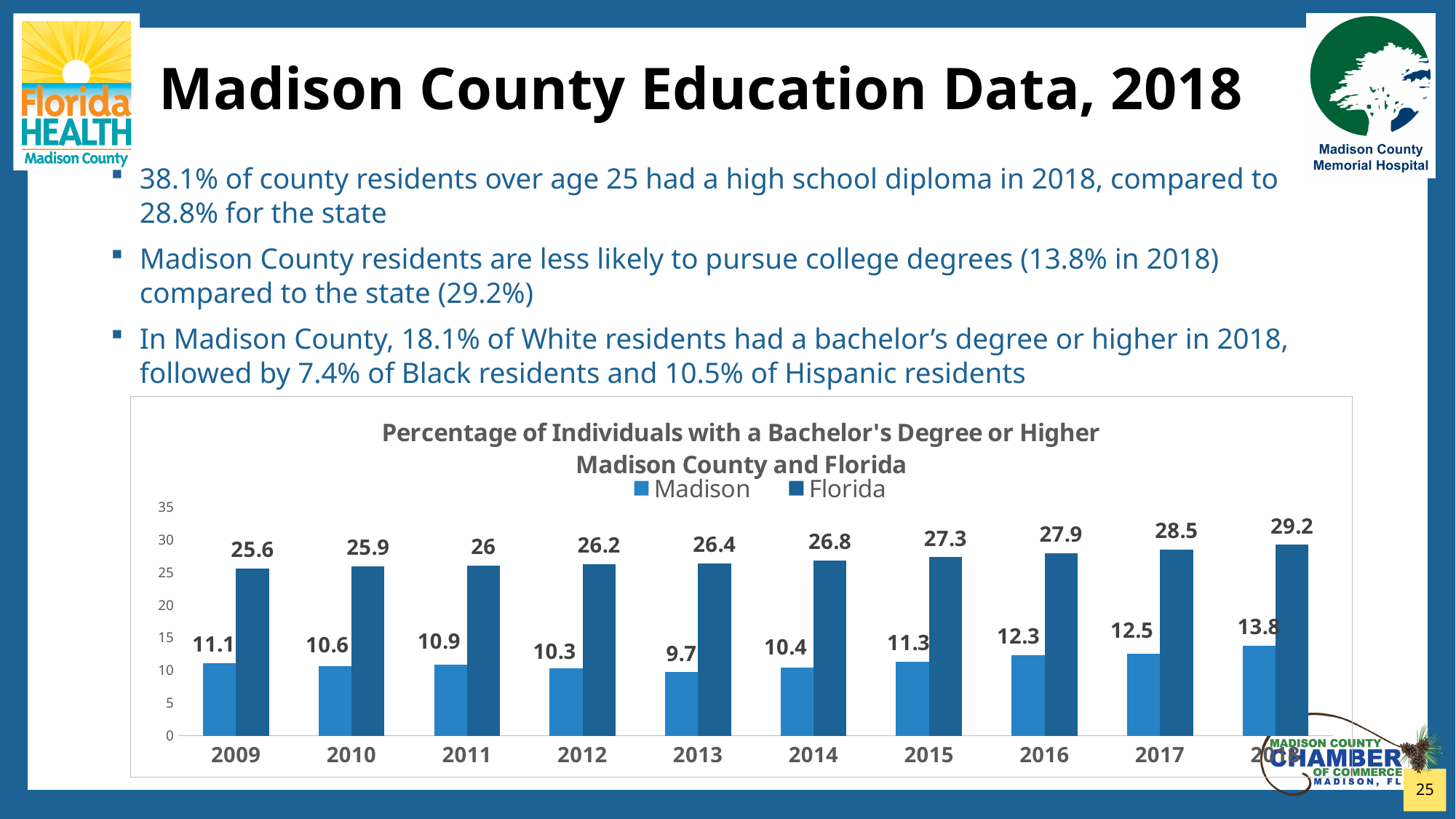
What is the Madison value for 2009? 11.1 Which is larger in 2011, the Madison value or the Florida value? Florida Do the Florida values rise or fall from 2009 to 2018? Rise What is the title of the chart? Percentage of Individuals with a Bachelor's Degree or Higher Madison County and Florida What type of chart is shown on the slide? Bar chart In which year is the Florida value highest? 2018 What is the Florida value for 2014? 26.8 What is the difference between the Florida and Madison values in 2016? 15.6 In which year is the Madison value lowest? 2013 How many years are shown on the x axis of the chart? 10 What is the Madison value for 2013? 9.7 How many series does the chart legend list? 2